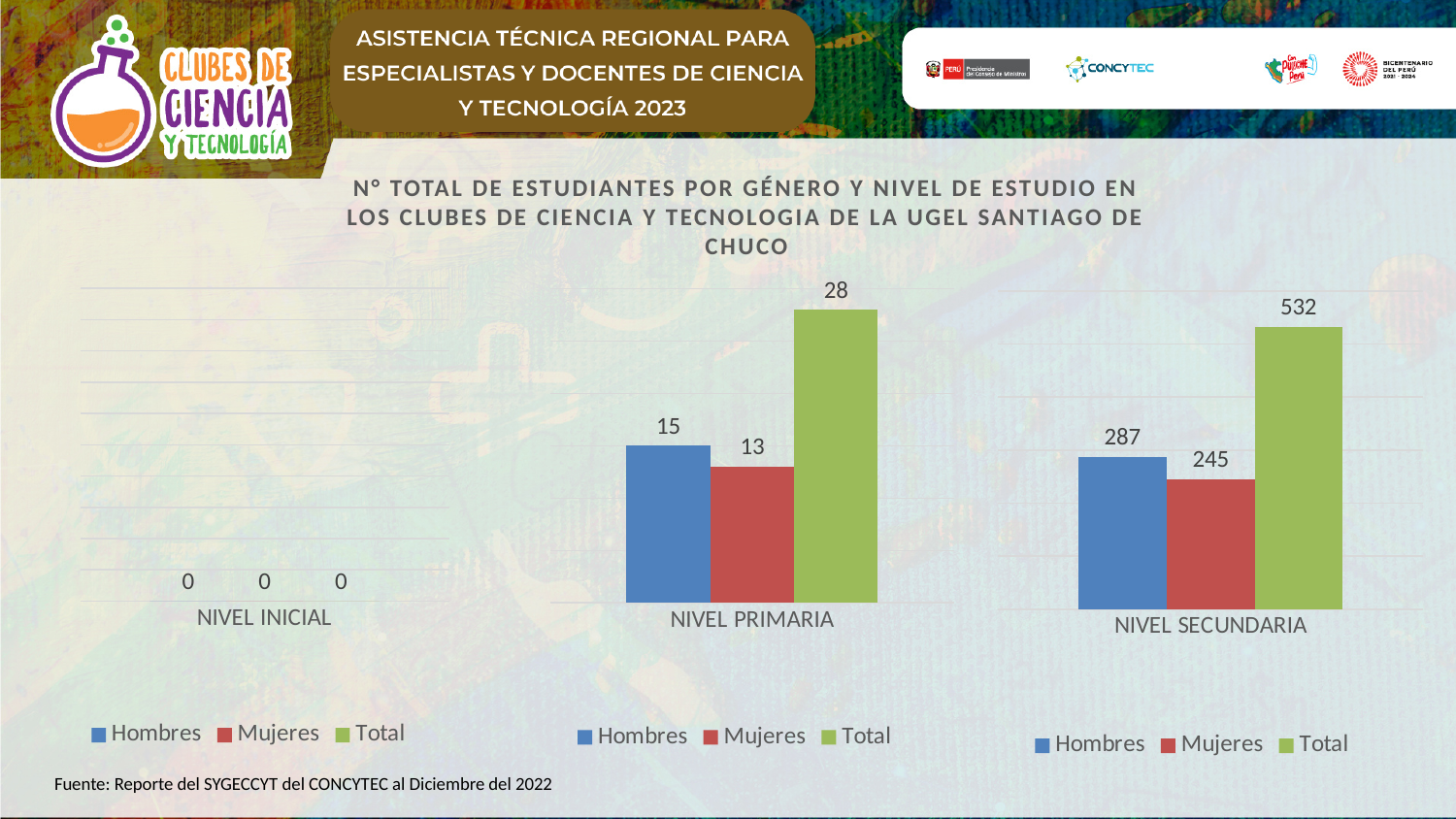
In the NIVEL INICIAL chart, what is the value for Hombres? 0 In the NIVEL SECUNDARIA chart, which series has the highest value? Total In the NIVEL SECUNDARIA chart, what is the value for Total? 532 What kind of chart is the NIVEL PRIMARIA chart? Bar chart In the NIVEL SECUNDARIA chart, what is the value for Mujeres? 245 In the NIVEL PRIMARIA chart, what is the value for Hombres? 15 What colour represents Total in the legend of the NIVEL INICIAL chart? Green In the NIVEL PRIMARIA chart, what is the value for Mujeres? 13 In the NIVEL PRIMARIA chart, which series has the lowest value? Mujeres In the NIVEL PRIMARIA chart, which is larger, Hombres or Mujeres? Hombres In the NIVEL SECUNDARIA chart, what is the difference between Hombres and Mujeres? 42 How many series does the legend of the NIVEL SECUNDARIA chart list? 3